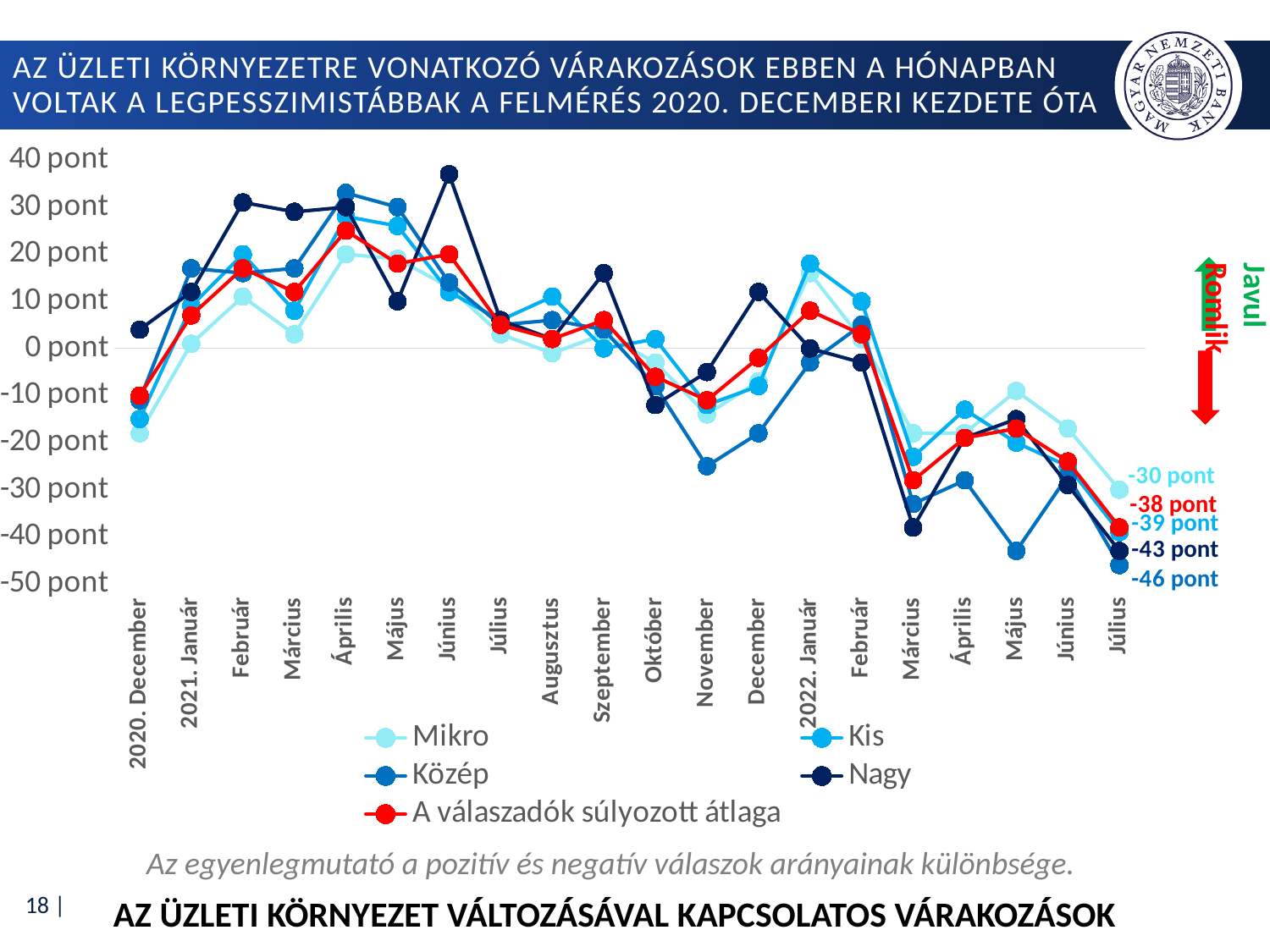
How many months (points) are shown along the x axis? 20 What kind of chart is shown on the slide? line chart What is the value for Nagy in 2022 Július? -43 pont How many series does the legend list? 5 What is the difference between the Mikro and Közép values in 2022 Július? 16 pont Does 'A válaszadók súlyozott átlaga' rise or fall from 2022 Január to 2022 Július? fall What is the value for Mikro in 2022 Július? -30 pont Which series has the highest value in 2022 Július? Mikro What is the value of 'A válaszadók súlyozott átlaga' in 2022 Július? -38 pont Which series has the lowest value in 2022 Július? Közép What is the value for Közép in 2022 Július? -46 pont Is the value for Nagy in 2021 Június greater or less than 30 pont? greater